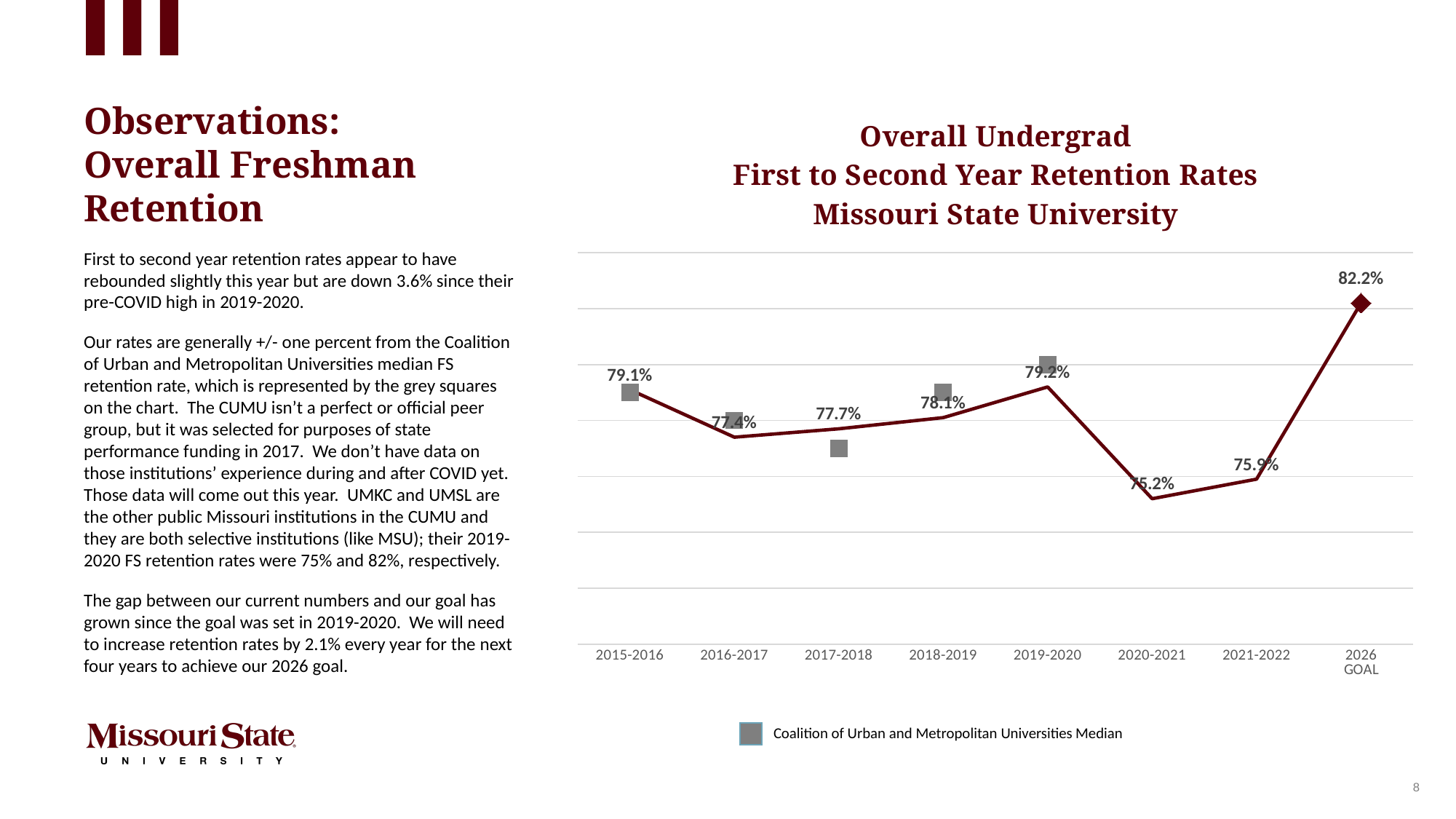
What is the difference between the 2019-2020 and 2020-2021 retention rates? 4.0% What is the retention rate shown for 2019-2020? 79.2% What does the grey square in the legend represent? Coalition of Urban and Metropolitan Universities Median Which is larger, the retention rate for 2016-2017 or for 2018-2019? 2018-2019 Which year on the x axis has the lowest retention rate? 2020-2021 What is the difference between the 2026 GOAL value and the 2021-2022 retention rate? 6.3% Which point on the chart has the highest value? 2026 GOAL What value is shown for the 2026 GOAL? 82.2% What is the retention rate shown for 2015-2016? 79.1% What is the retention rate shown for 2020-2021? 75.2% What kind of chart is shown on the slide? Line chart How many points are plotted along the x axis of the chart? 8